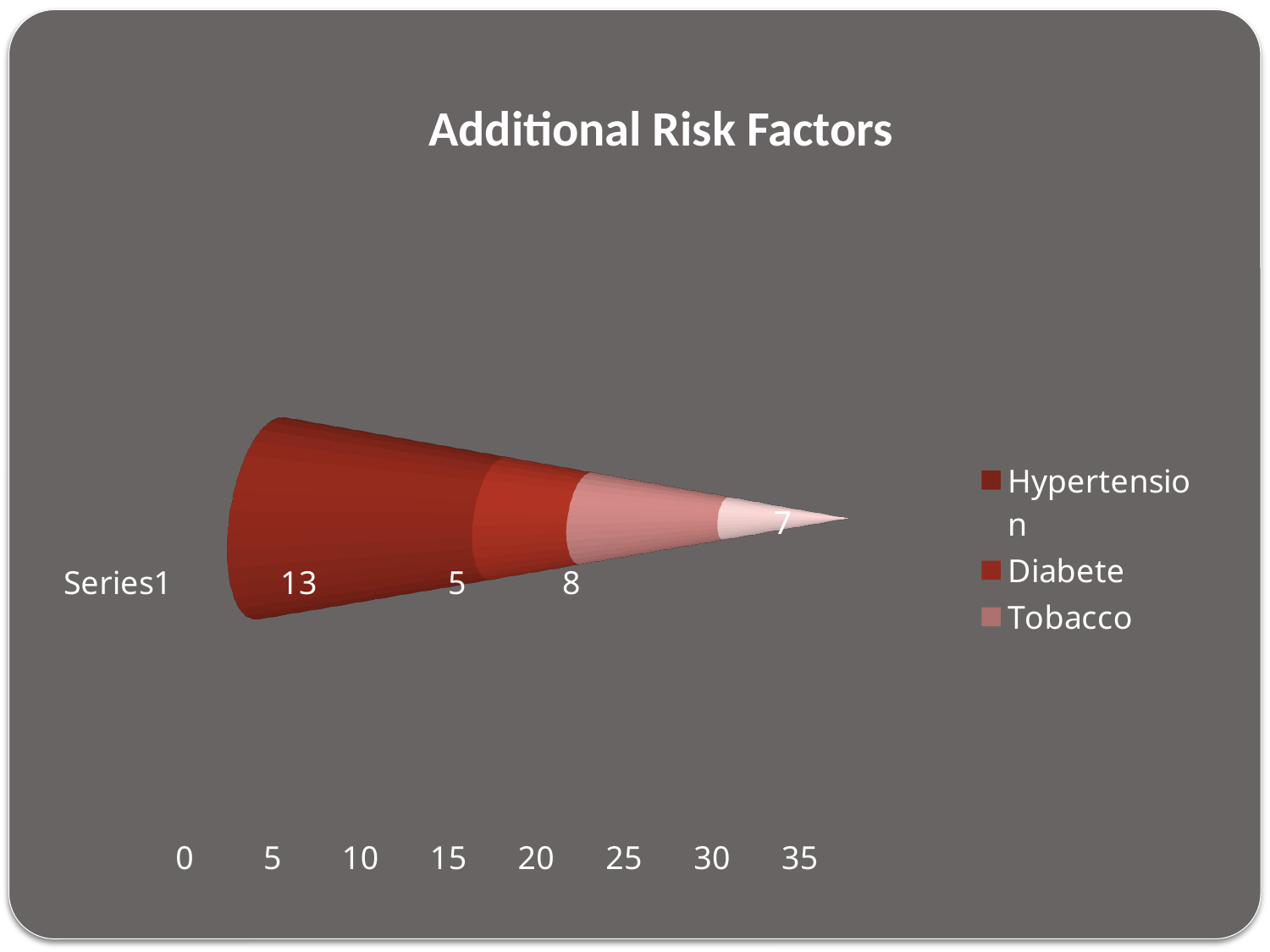
What is the value for Tobacco? 8 What kind of chart is shown on the slide? bar chart What is the difference between the values for Tobacco and Diabete? 3 How many series does the legend list? 3 Which of the series listed in the legend has the highest value? Hypertension What is the value for Hypertension? 13 What is the value for Diabete? 5 Which of the series listed in the legend has the lowest value? Diabete Which is larger, the value for Hypertension or the value for Tobacco? Hypertension What is the title of the chart? Additional Risk Factors What is the total of all the labelled segments in the Series1 bar? 33 What is the difference between the values for Hypertension and Tobacco? 5